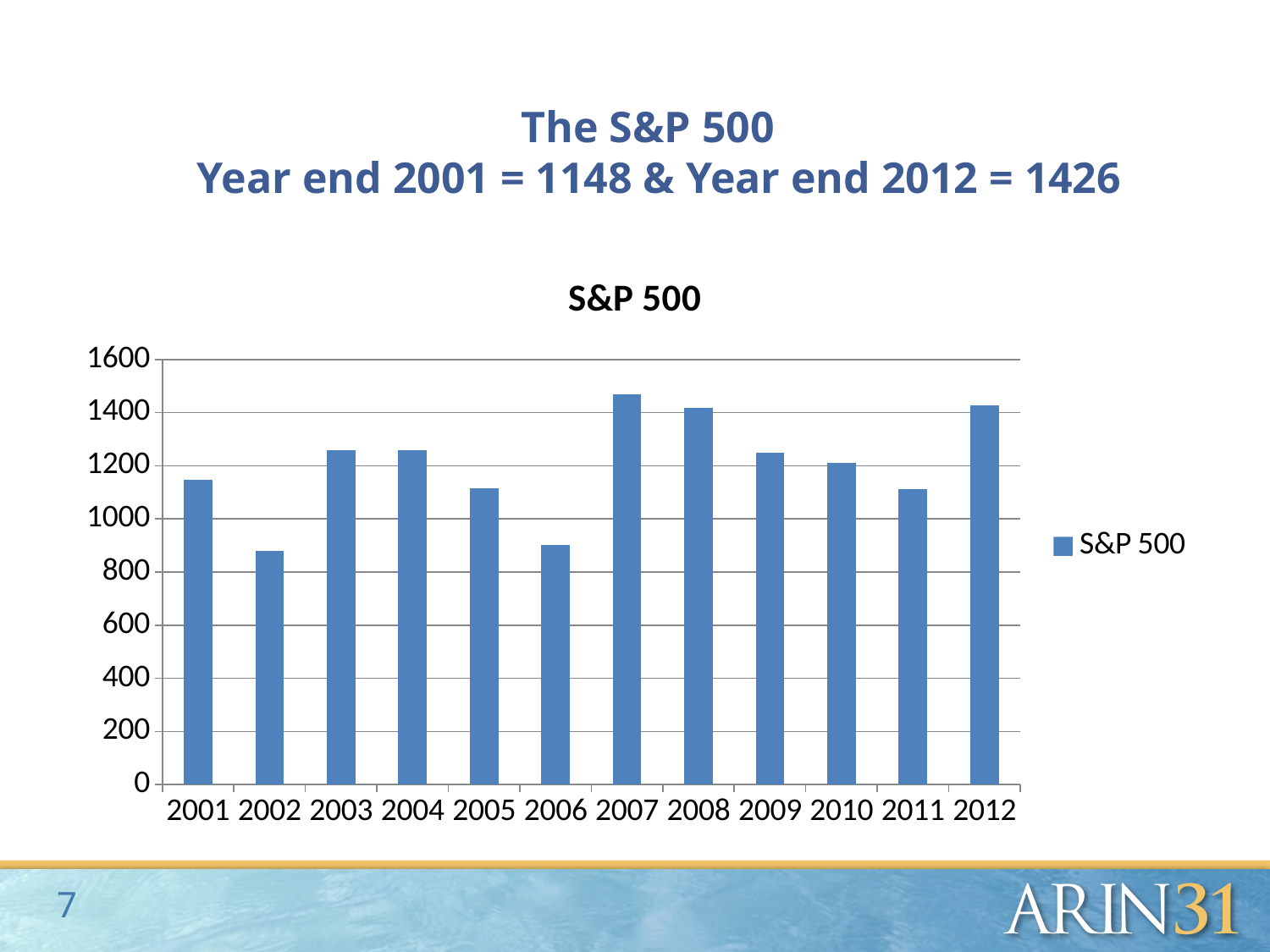
What is the S&P 500 value at year end 2001? 1148 Is the value for 2002 greater or less than 1000? less Is the value for 2006 greater or less than 1000? less What is the S&P 500 value at year end 2012? 1426 How many years are shown on the x axis? 12 What kind of chart is shown? bar chart Which is larger, the value for 2007 or the value for 2002? 2007 What is the difference between the year end 2012 value and the year end 2001 value? 278 Which is larger, the value for 2003 or the value for 2005? 2003 Which year has the highest S&P 500 bar? 2007 How many series does the legend list? 1 Is the value for 2007 greater or less than 1400? greater